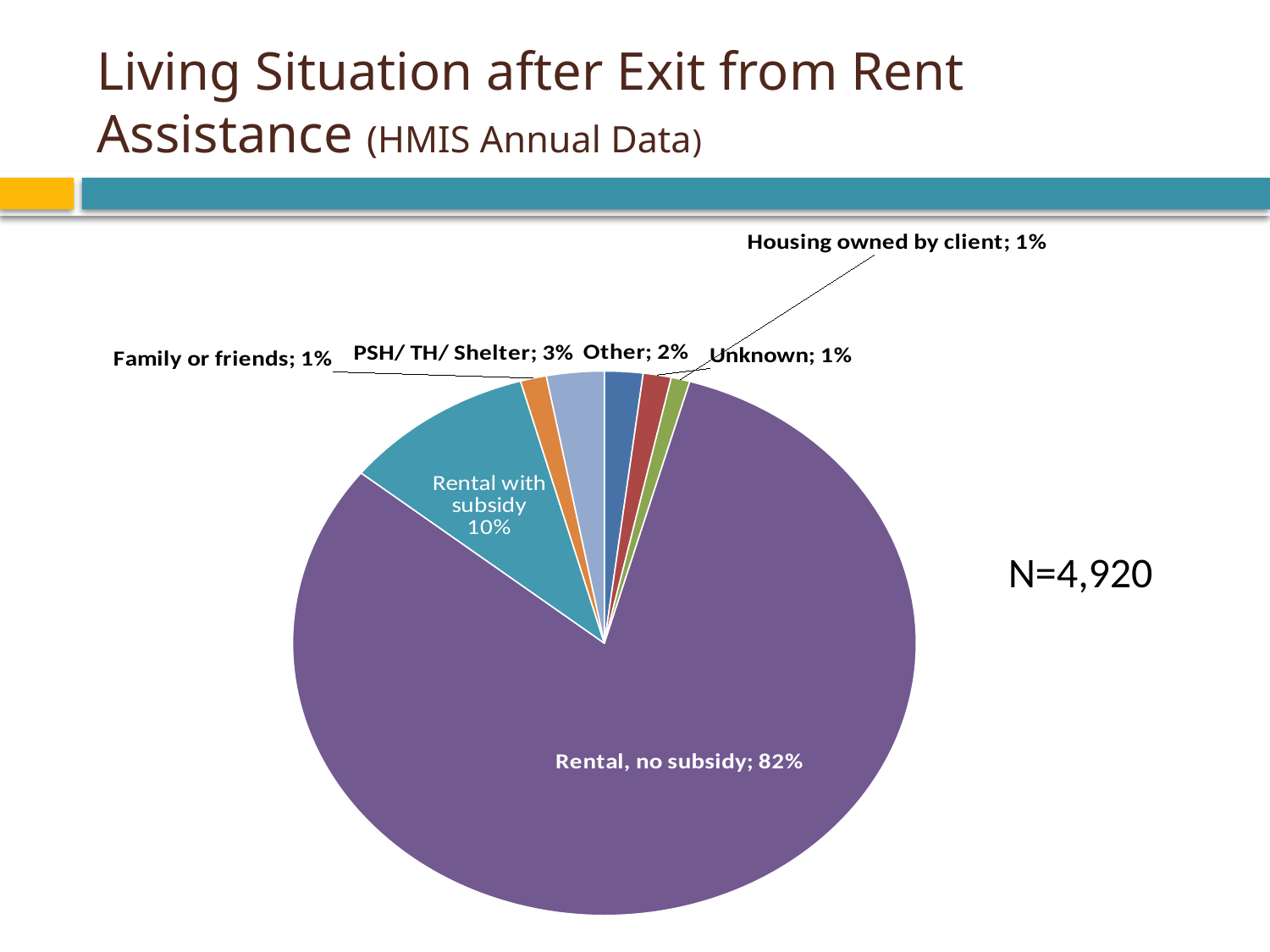
How many slices does the pie chart have? 7 What is the difference in percentage points between Rental, no subsidy and Rental with subsidy? 72 Which is larger, the share for PSH/ TH/ Shelter or the share for Other? PSH/ TH/ Shelter Which category has the largest slice of the pie? Rental, no subsidy What share of the pie is Rental, no subsidy? 82% What share of the pie is Rental with subsidy? 10% What percentage is shown for Housing owned by client? 1% What kind of chart is shown on the slide? pie chart What is the N value shown next to the chart? N=4,920 What percentage is shown for PSH/ TH/ Shelter? 3% What percentage is shown for Other? 2% What percentage is shown for Family or friends? 1%